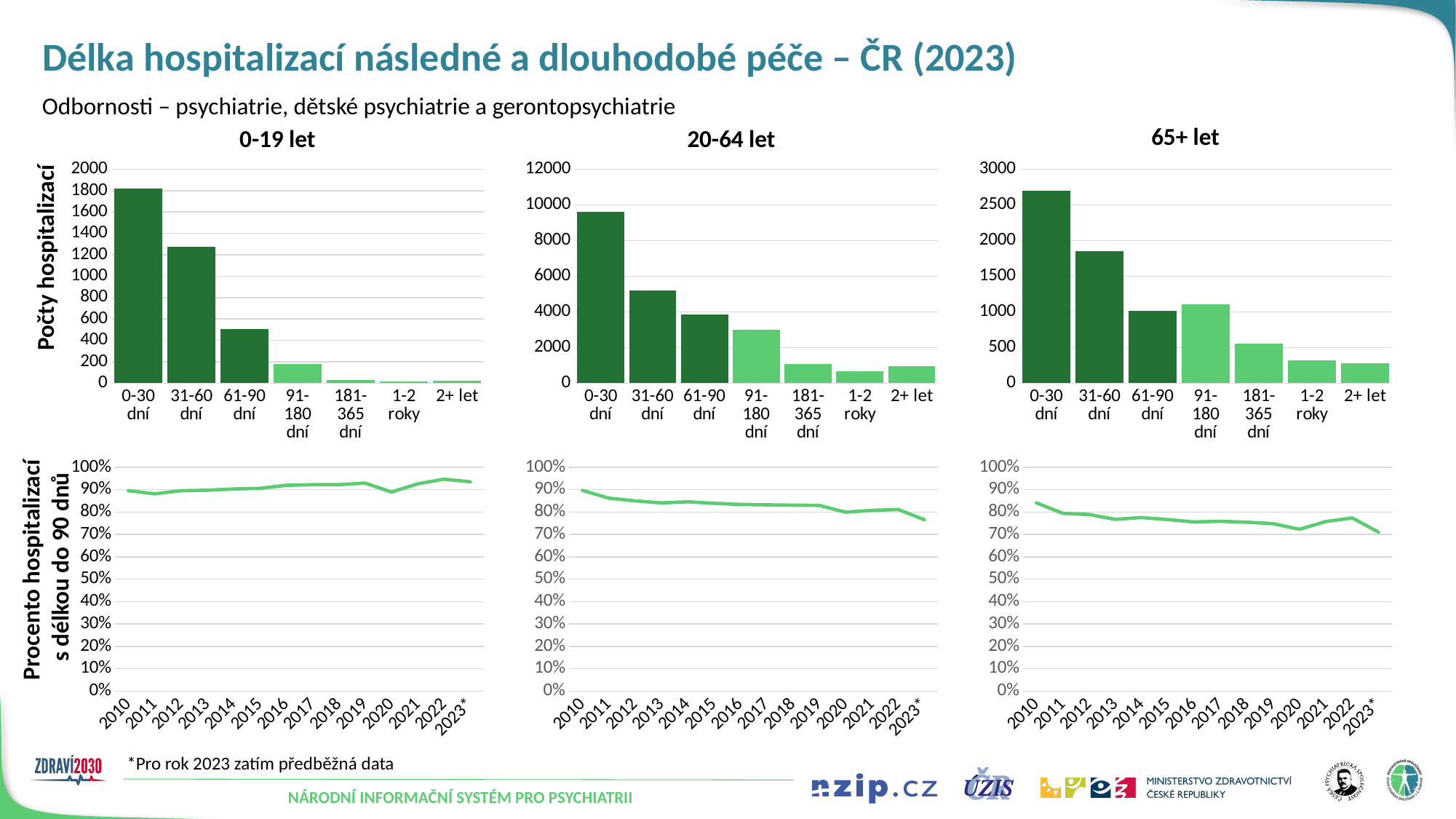
In the top-left bar chart titled '0-19 let', is the value for '0-30 dní' greater or less than 1600? greater What kind of chart is the bottom-middle chart for '20-64 let' showing 'Procento hospitalizací s délkou do 90 dnů'? line chart In the top-right bar chart titled '65+ let', is the value for '0-30 dní' greater or less than 2000? greater In the top-middle bar chart titled '20-64 let', which is larger, the value for '31-60 dní' or the value for '91-180 dní'? 31-60 dní In the bottom-right line chart for '65+ let', is the value for 2023* greater or less than 80%? less In the top-left bar chart titled '0-19 let', which category has the highest number of hospitalizations? 0-30 dní How many categories are shown on the x axis of the top-right bar chart titled '65+ let'? 7 In the bottom-right line chart for '65+ let', do the values generally rise or fall from 2010 to 2023? fall In the top-middle bar chart titled '20-64 let', which category has the lowest number of hospitalizations? 1-2 roky